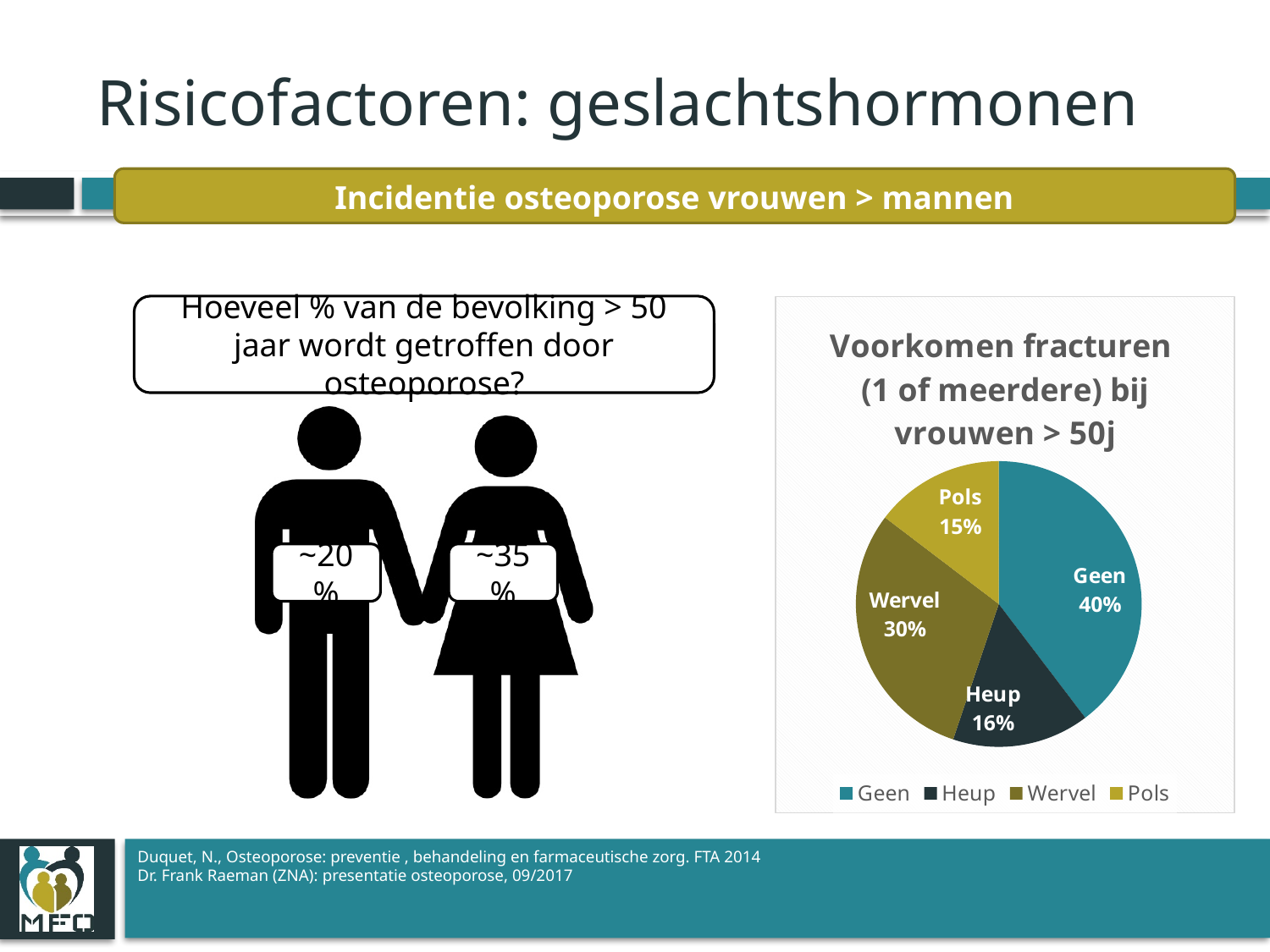
Which category has the largest slice in the pie chart? Geen Which category has the smallest slice in the pie chart? Pols What percentage does the Pols slice represent in the pie chart? 15% What percentage does the Geen slice represent in the pie chart? 40% Which slice is larger in the pie chart, Wervel or Heup? Wervel What is the difference in percentage points between the Geen and Wervel slices? 10 How many slices does the pie chart have? 4 What kind of chart is shown on the slide? pie chart What is the title of the pie chart? Voorkomen fracturen (1 of meerdere) bij vrouwen > 50j What percentage does the Heup slice represent in the pie chart? 16% What percentage does the Wervel slice represent in the pie chart? 30% How many entries does the legend of the pie chart list? 4